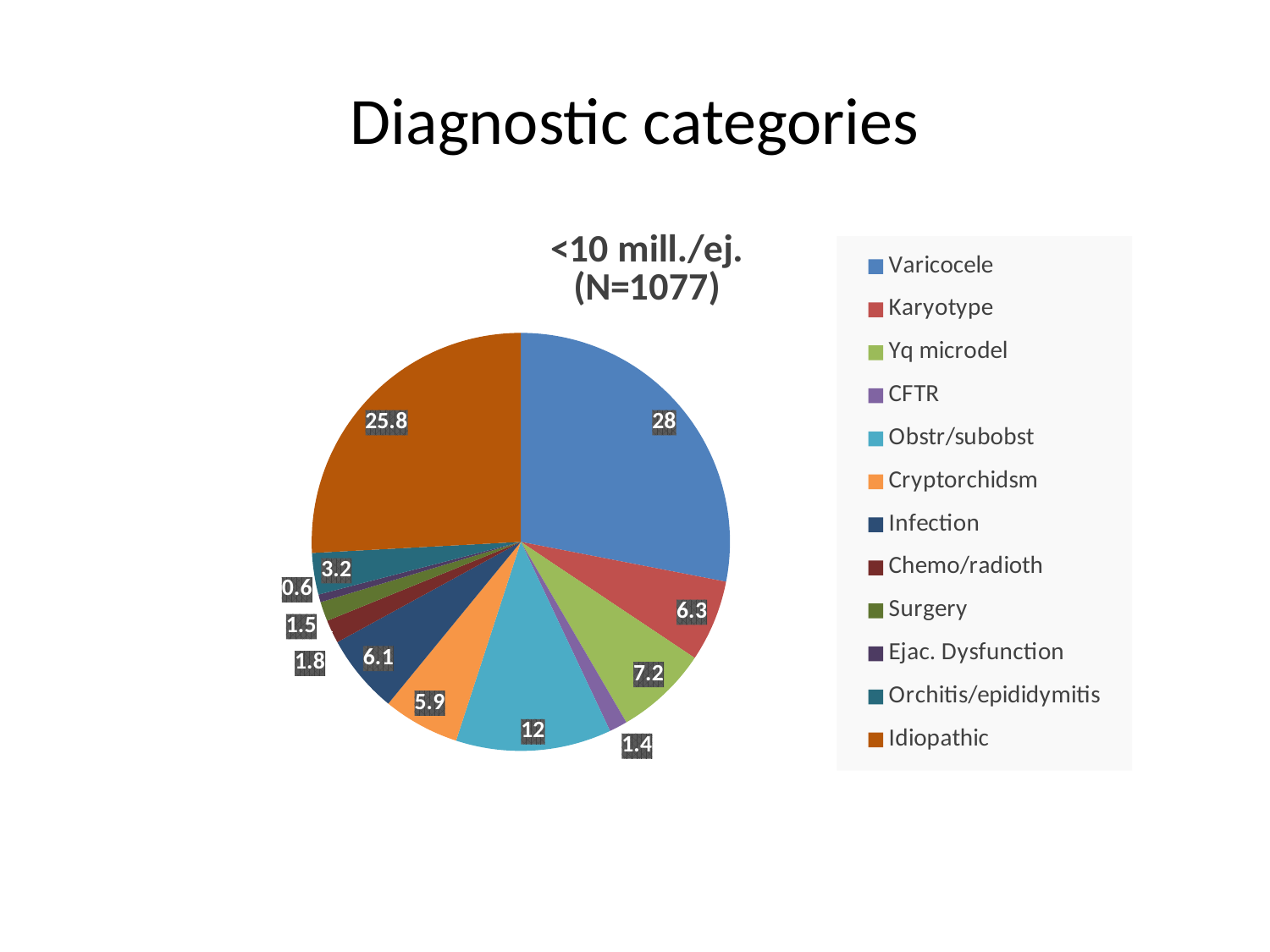
What is the value for Obstr/subobst? 12 Which category has the smallest slice? Ejac. Dysfunction What is the value for Varicocele? 28 What is the title shown above the pie chart? <10 mill./ej. (N=1077) What is the value for Ejac. Dysfunction? 0.6 How many categories does the legend list? 12 What is the difference between the values for Obstr/subobst and Cryptorchidsm? 6.1 What is the difference between the values for Varicocele and Idiopathic? 2.2 Which is larger, the value for Yq microdel or the value for Karyotype? Yq microdel What type of chart is shown on the slide? pie chart Which category has the largest slice? Varicocele What is the value for Idiopathic? 25.8